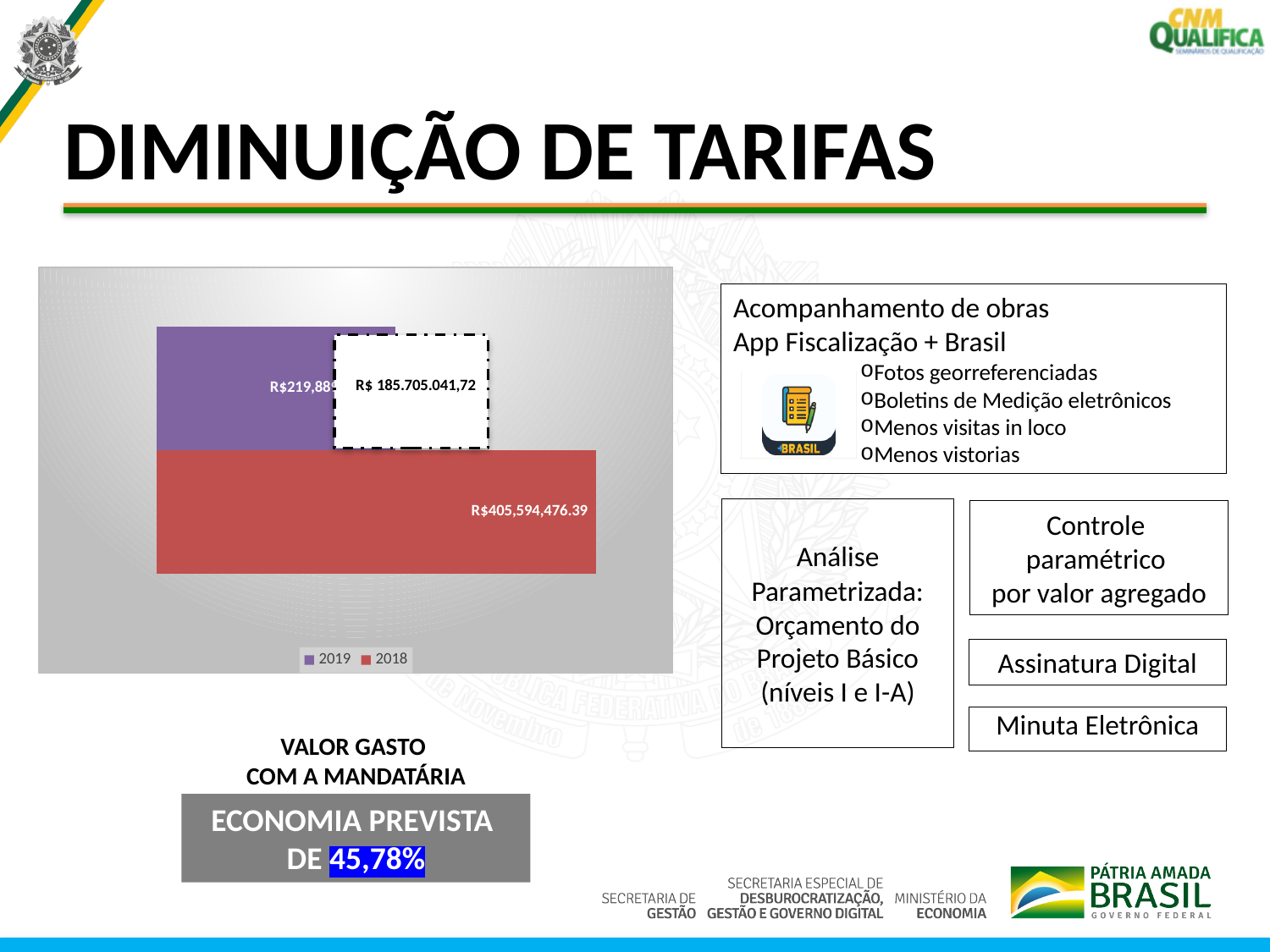
What is the value shown on the 2018 bar? R$405,594,476.39 How many bars are plotted in the chart? 2 Is the value for 2018 greater or less than R$400,000,000? greater Which series has the lowest value in the chart? 2019 How many series does the chart legend list? 2 Which series has the larger bar, 2019 or 2018? 2018 Which colour represents the 2018 series in the chart? Red What kind of chart is shown on the slide? Bar chart Which series has the highest value in the chart? 2018 What are the two series named in the chart legend? 2019 and 2018